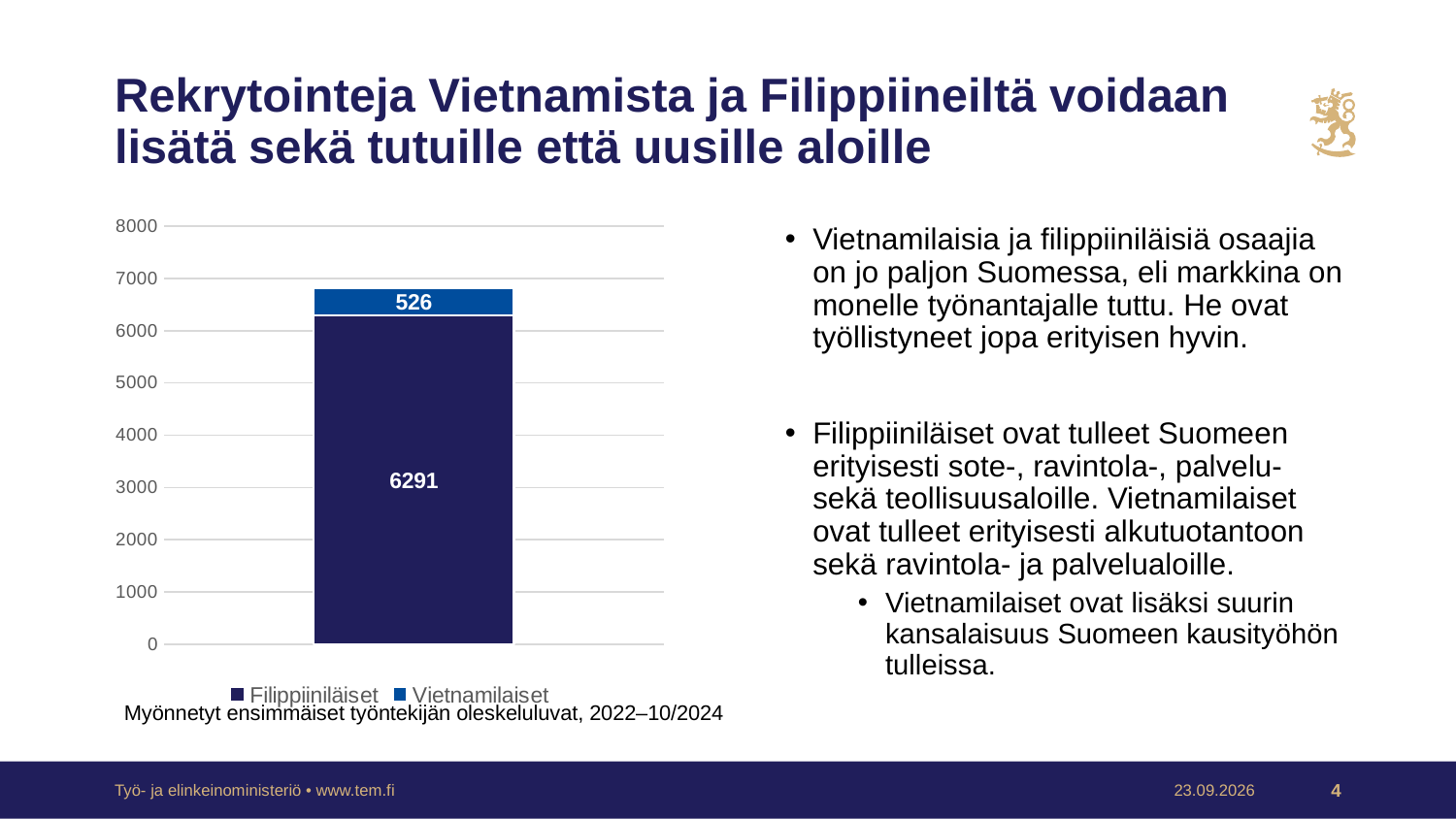
What kind of chart is shown on the slide? Stacked bar chart How many series does the legend list? 2 What is the difference between the values for Filippiiniläiset and Vietnamilaiset? 5765 What caption is printed below the chart? Myönnetyt ensimmäiset työntekijän oleskeluluvat, 2022–10/2024 Which series has the larger value, Filippiiniläiset or Vietnamilaiset? Filippiiniläiset Is the value for Filippiiniläiset greater or less than 6000? greater What is the value for Filippiiniläiset in the chart? 6291 What is the value for Vietnamilaiset in the chart? 526 Which series has the smallest value in the chart? Vietnamilaiset What is the total of the stacked bar in the chart? 6817 Is the total of the stacked bar greater or less than 7000? less What is the maximum value shown on the vertical axis of the chart? 8000